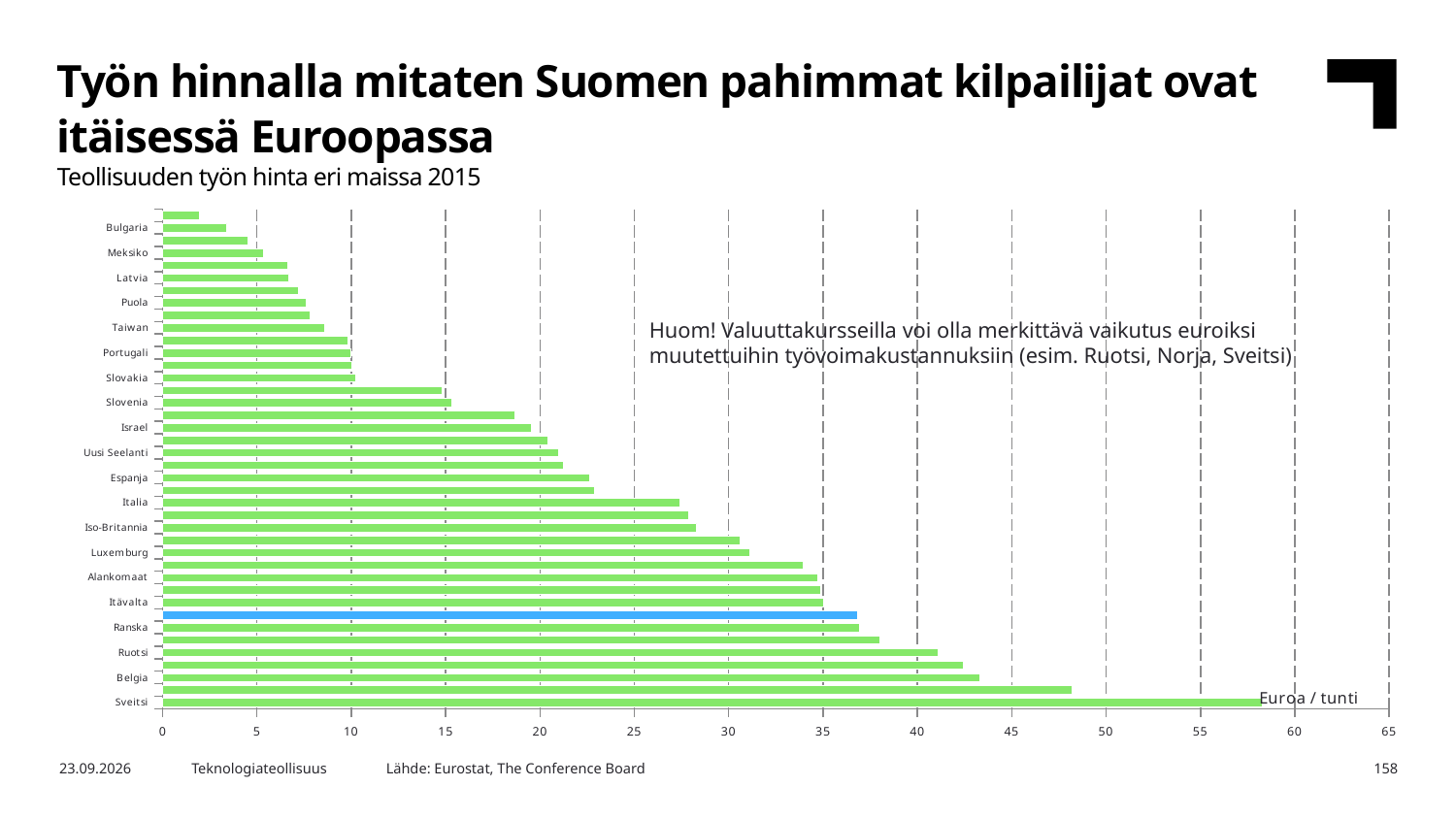
What is the subtitle of the chart? Teollisuuden työn hinta eri maissa 2015 Is the value for Belgia greater or less than 40? greater Is the value for Sveitsi greater or less than 55? greater Is the value for Iso-Britannia greater or less than 30? less Which has the higher value, Italia or Espanja? Italia What kind of chart is shown on the slide? bar chart Which country has the highest labour cost in the chart? Sveitsi What unit is shown on the chart's value axis? Euroa / tunti Which has the higher value, Belgia or Ruotsi? Belgia